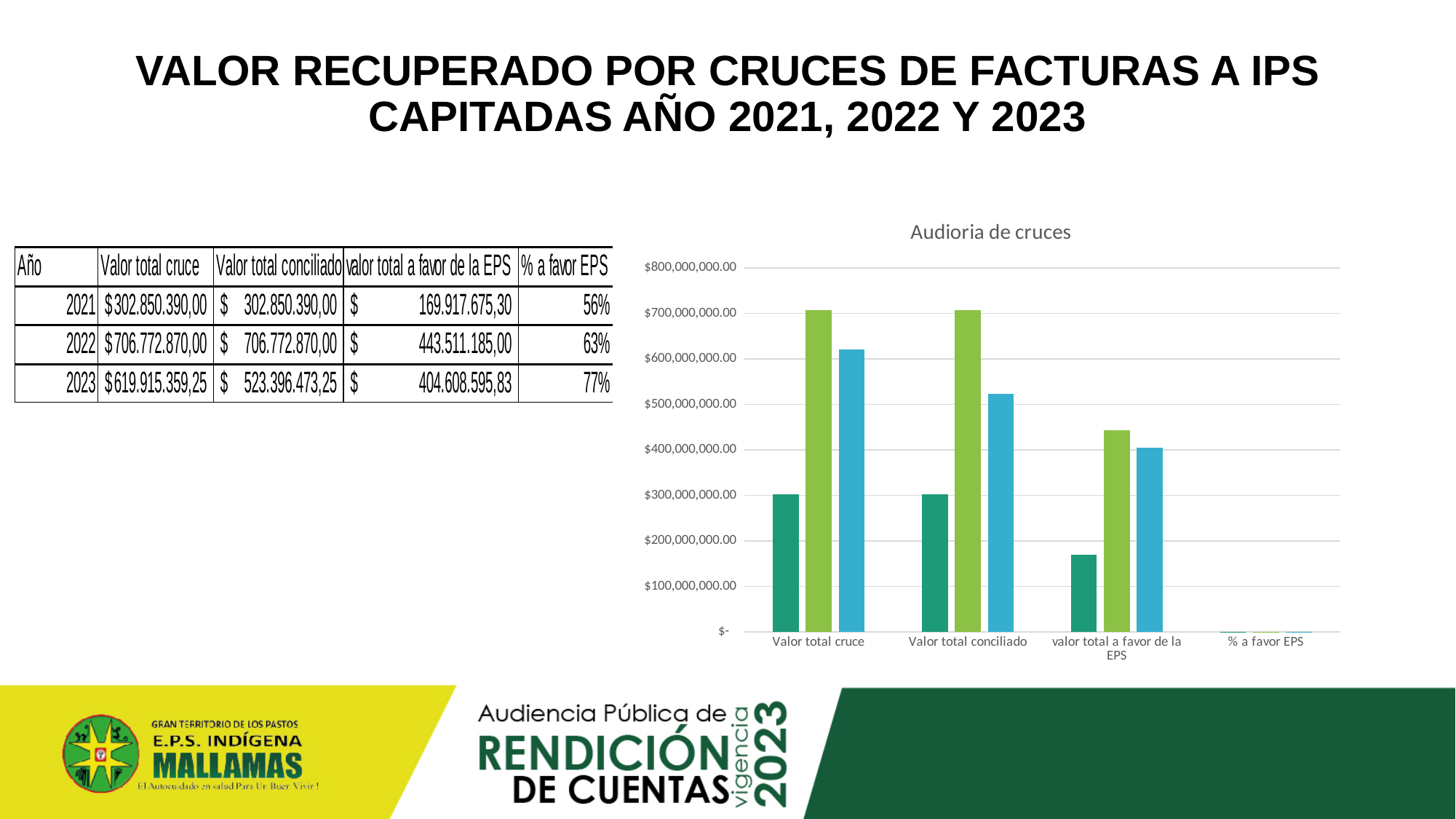
In the 'Valor total cruce' group of the chart, is the first (dark green) bar greater or less than $400,000,000.00? less Which is taller in the chart: the first bar of 'Valor total cruce' or the first bar of 'valor total a favor de la EPS'? the first bar of Valor total cruce In the 'Valor total cruce' group of the chart, which is taller: the light green bar or the blue bar? the light green bar How many bars are plotted for the 'Valor total cruce' category in the chart? 3 In the 'valor total a favor de la EPS' group of the chart, is the first (dark green) bar greater or less than $200,000,000.00? less What type of chart is shown under the title 'Audioria de cruces'? bar chart In the 'Valor total cruce' group of the chart, is the third (blue) bar greater or less than $600,000,000.00? greater Which category in the 'Audioria de cruces' chart has the lowest bars? % a favor EPS What is the title of the chart on the right side of the slide? Audioria de cruces How many categories are shown on the x axis of the 'Audioria de cruces' chart? 4